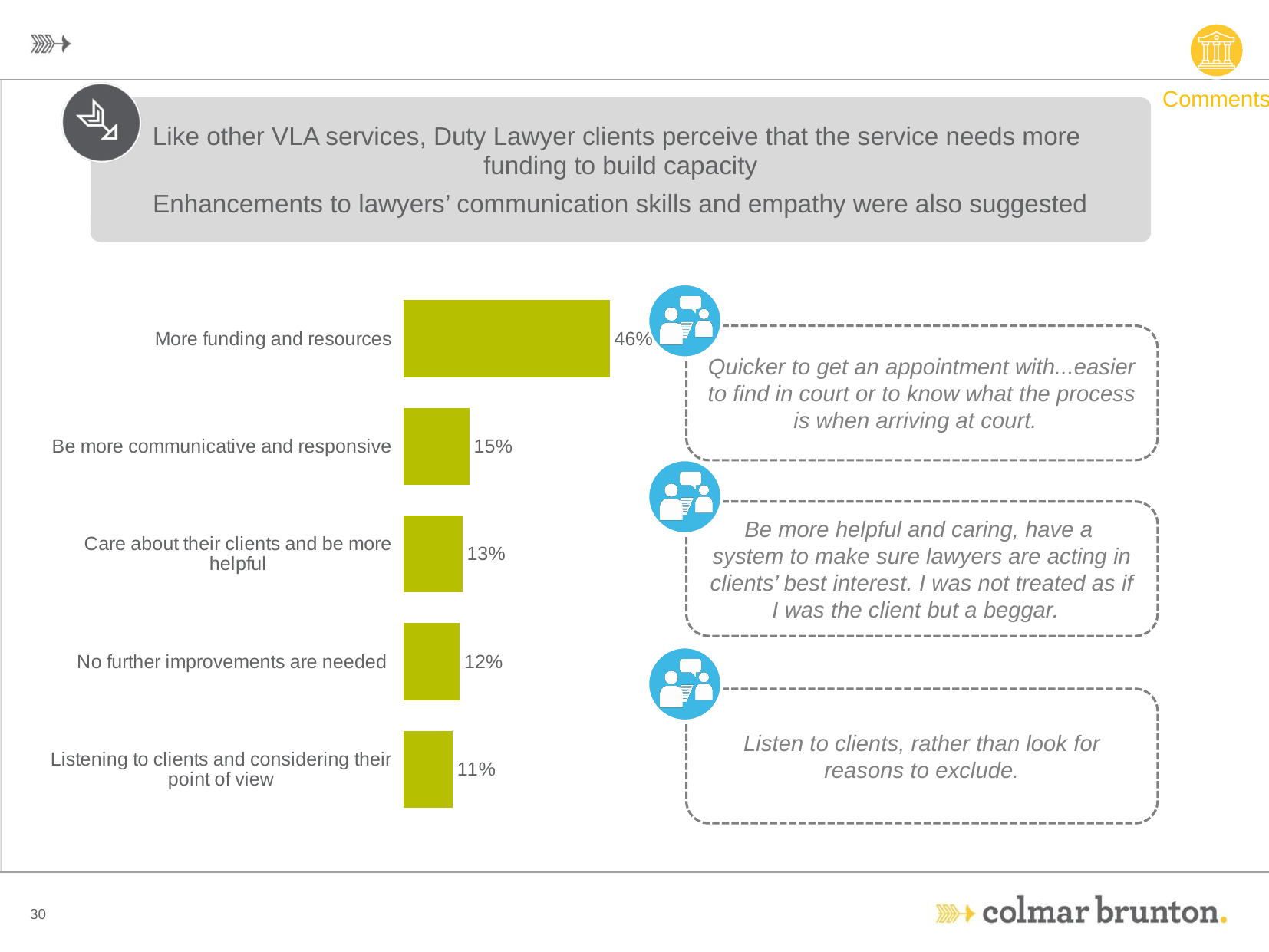
What colour are the bars in the chart? Yellow-green What is the value for 'No further improvements are needed'? 12% Which category has the lowest value in the chart? Listening to clients and considering their point of view What is the difference between 'More funding and resources' and 'Be more communicative and responsive'? 31 percentage points What percentage is shown for 'Care about their clients and be more helpful'? 13% How many categories are shown in the chart? 5 Which is larger: 'Be more communicative and responsive' or 'No further improvements are needed'? Be more communicative and responsive What kind of chart is shown on the slide? Bar chart Which category has the highest value in the chart? More funding and resources What percentage is shown for 'Listening to clients and considering their point of view'? 11% What percentage of Duty Lawyer clients suggested more funding and resources? 46% What is the value for 'Be more communicative and responsive'? 15%